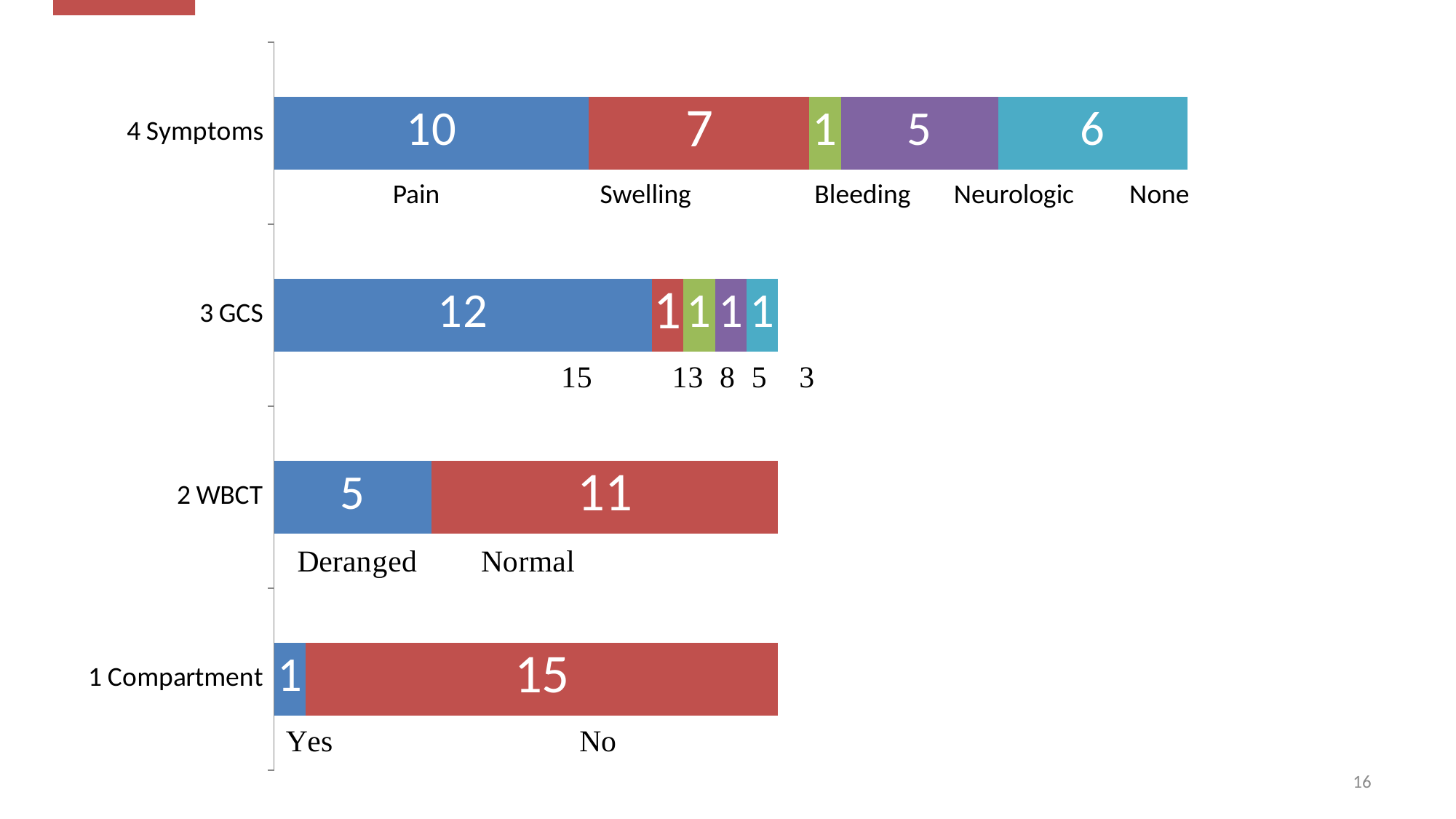
What is the value for Swelling in the 4 Symptoms bar? 7 Which is larger in the 4 Symptoms bar, None or Neurologic? None What kind of chart is shown on the slide? Stacked bar chart What is the difference between the Normal and Deranged values in the 2 WBCT bar? 6 What is the value for Pain in the 4 Symptoms bar? 10 What is the value for No in the 1 Compartment bar? 15 What is the value for the GCS 15 segment in the 3 GCS bar? 12 What is the total of the 4 Symptoms stacked bar? 29 Which symptom has the highest value in the 4 Symptoms bar? Pain How many category bars are shown on the chart? 4 What is the value for Normal in the 2 WBCT bar? 11 Which symptom has the lowest value in the 4 Symptoms bar? Bleeding